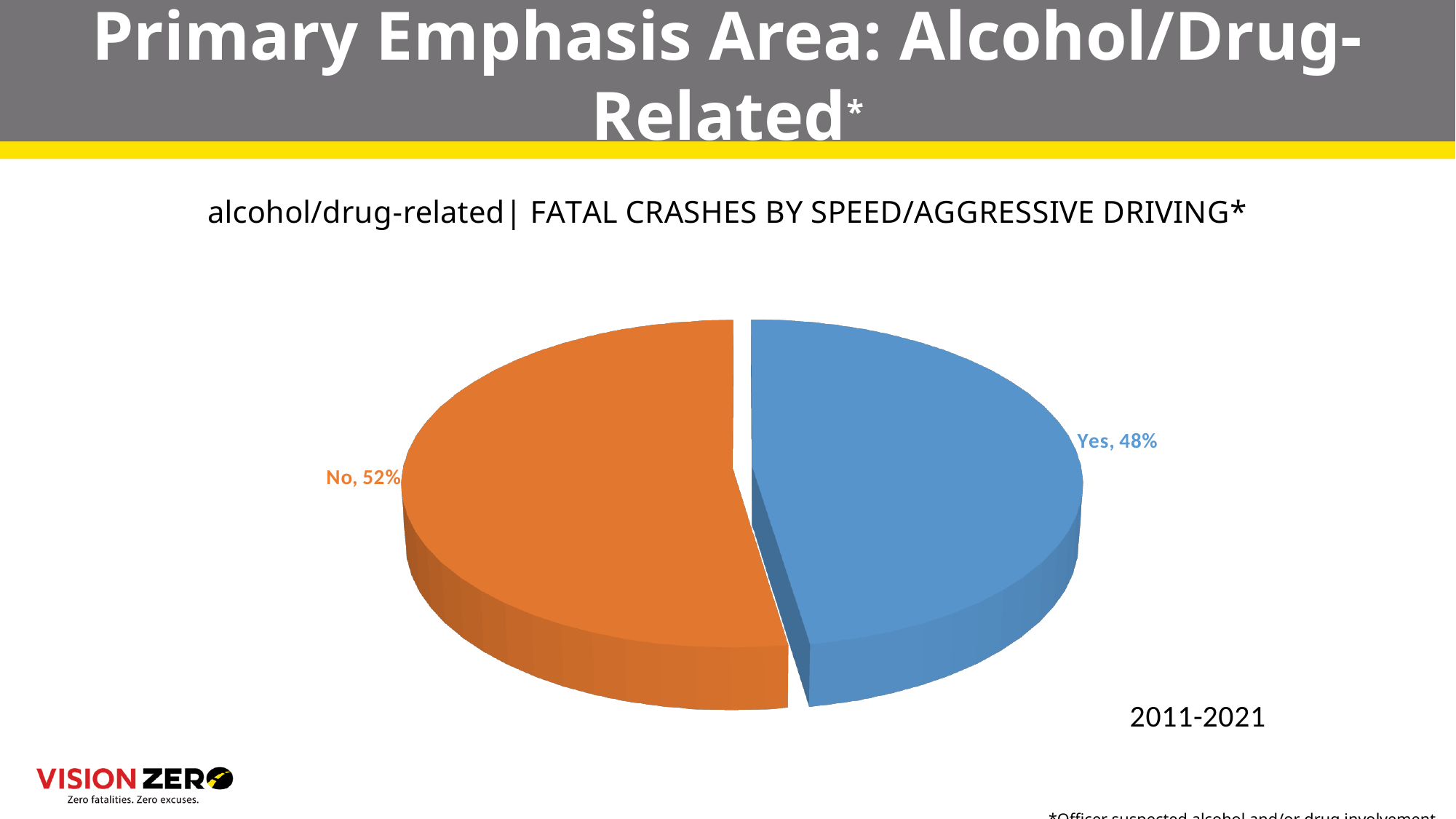
Which slice of the pie is larger, Yes or No? No What is the title of the chart? alcohol/drug-related| FATAL CRASHES BY SPEED/AGGRESSIVE DRIVING* What colour is the Yes slice of the pie? blue What time period does the chart cover? 2011-2021 What kind of chart is shown on the slide? pie chart What is the difference in percentage points between the No and Yes slices? 4 Which category has the smallest share of the pie? Yes What percentage of alcohol/drug-related fatal crashes involved speed/aggressive driving (Yes)? 48% What percentage of alcohol/drug-related fatal crashes did not involve speed/aggressive driving (No)? 52% Which category has the largest share of the pie? No How many slices does the pie chart have? 2